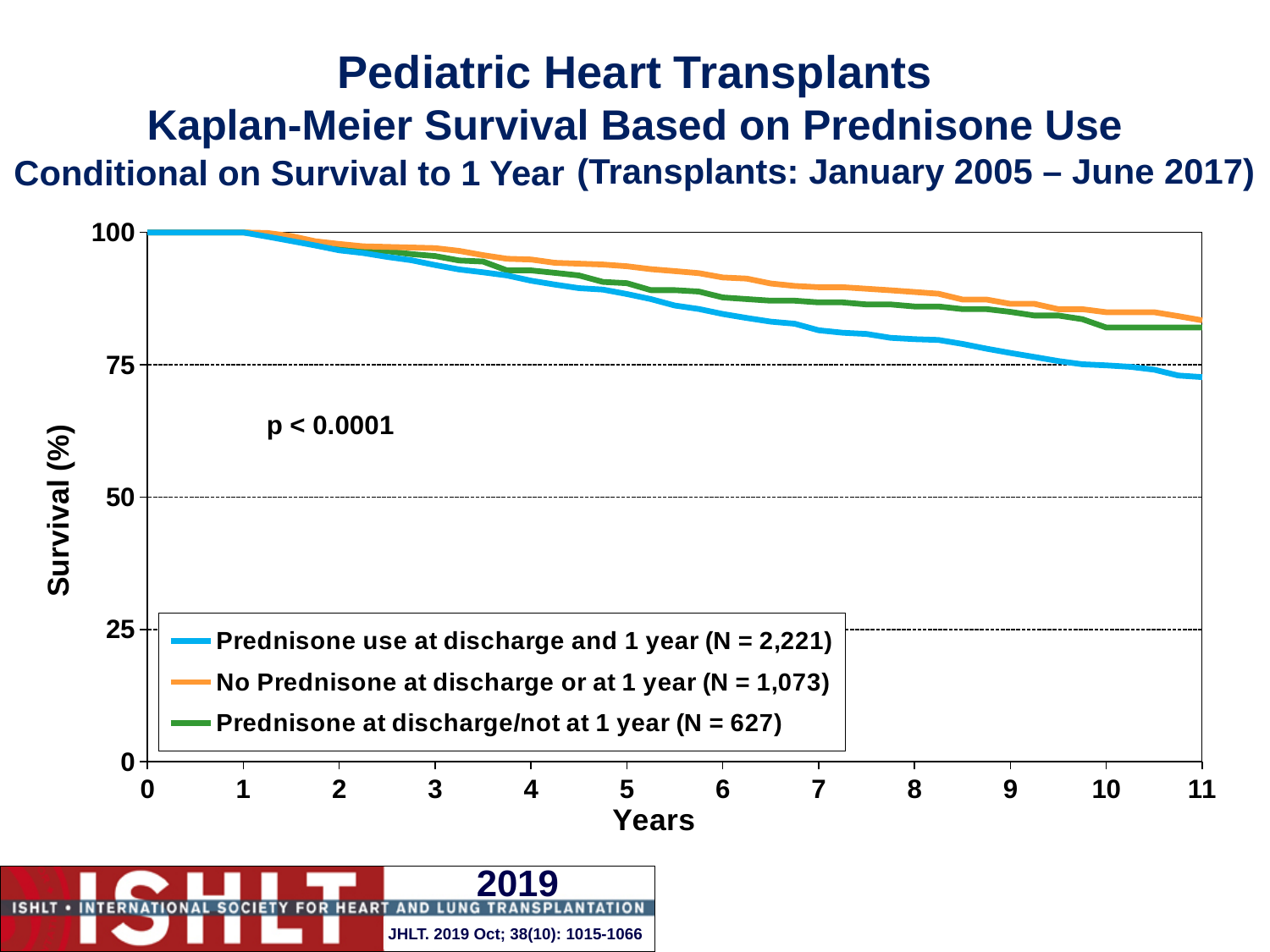
What is the N for the 'Prednisone at discharge/not at 1 year' series in the legend? 627 Which series has the highest survival at 11 years? No Prednisone at discharge or at 1 year (N = 1,073) What kind of chart is shown on the slide? line chart Is the survival value for 'No Prednisone at discharge or at 1 year' at 11 years greater or less than 75? greater How many series does the legend list? 3 At 11 years, which series has higher survival: 'No Prednisone at discharge or at 1 year' or 'Prednisone use at discharge and 1 year'? No Prednisone at discharge or at 1 year Which series has the lowest survival at 11 years? Prednisone use at discharge and 1 year (N = 2,221) Do the survival curves rise or fall as years increase? fall What p-value is printed on the chart? p < 0.0001 What is the survival value for all three series at 0 years? 100 Is the survival value for 'Prednisone at discharge/not at 1 year' at 11 years greater or less than 75? greater Is the survival value for 'Prednisone use at discharge and 1 year' at 11 years greater or less than 75? less